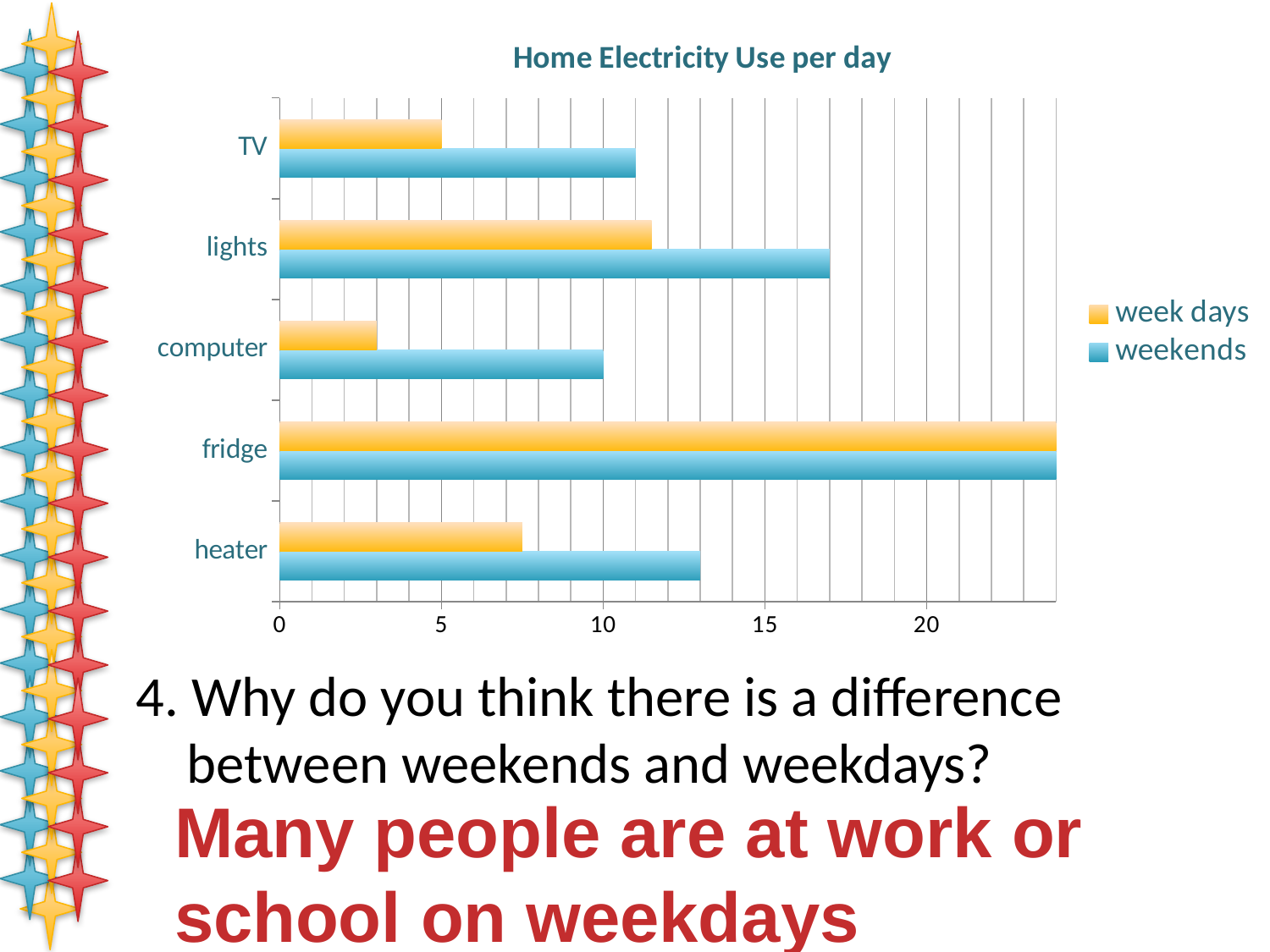
What is the title of the chart? Home Electricity Use per day What colour are the weekends bars? blue What is the week days value for TV? 5 What kind of chart is shown on the slide? bar chart Is the weekends value for lights greater or less than 15? greater Which category has the lowest week days value? computer What is the weekends value for computer? 10 How many series does the legend list? 2 Which category has the highest weekends value? fridge Is the week days value for heater greater or less than 10? less How many appliance categories are shown on the chart? 5 Which is larger, the weekends value for lights or the weekends value for TV? lights